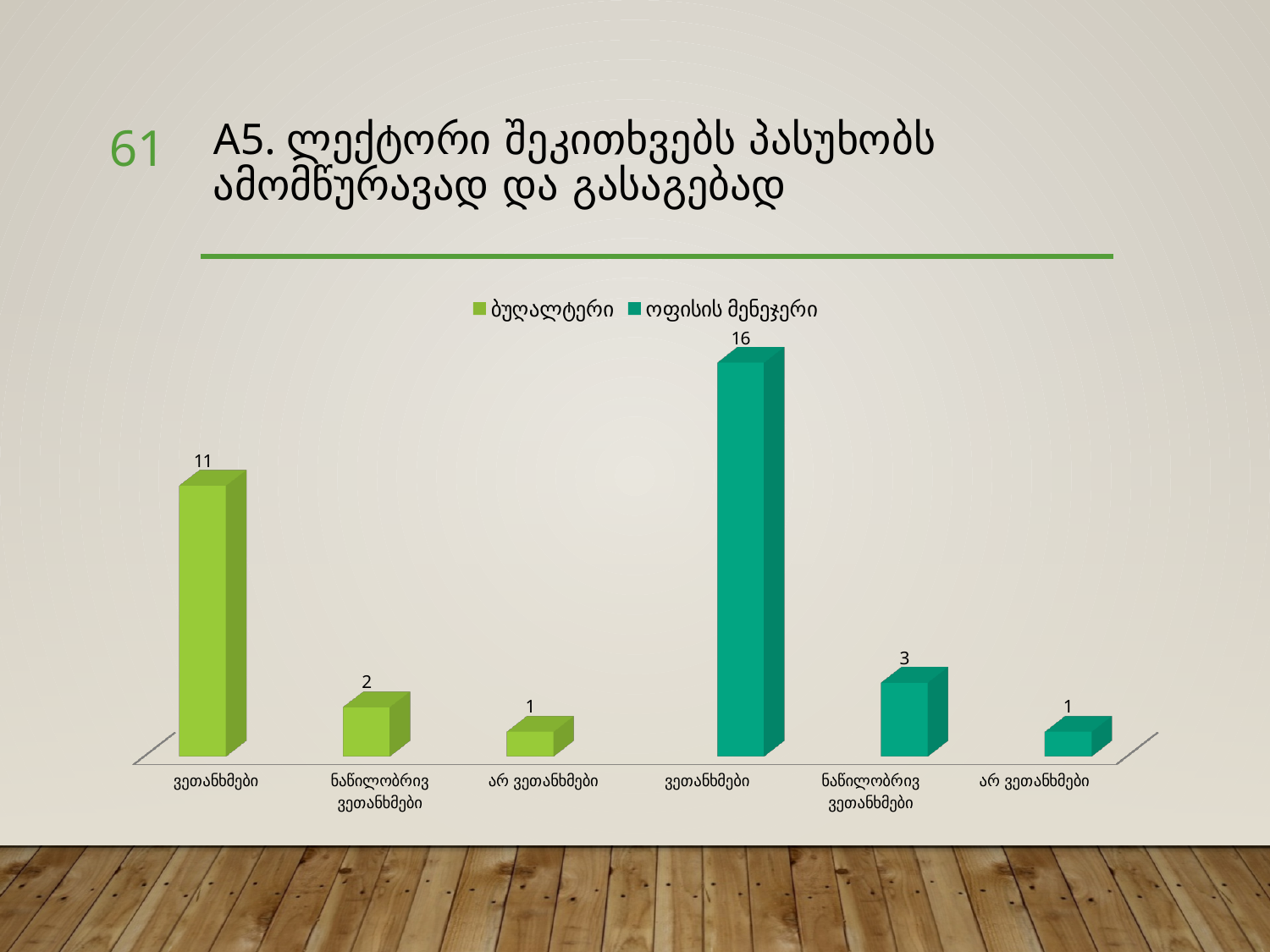
What kind of chart is shown on the slide? Bar chart What is the value for ვეთანხმები in the ბუღალტერი series? 11 Which category has the lowest value in the ოფისის მენეჯერი series? არ ვეთანხმები Which bar has the highest value on the chart? ვეთანხმები (ოფისის მენეჯერი) Which is larger: ნაწილობრივ ვეთანხმები for ბუღალტერი or for ოფისის მენეჯერი? ოფისის მენეჯერი What is the value for ვეთანხმები in the ოფისის მენეჯერი series? 16 What is the difference between the ვეთანხმები values for ოფისის მენეჯერი and ბუღალტერი? 5 How many series does the legend list? 2 How many bars are plotted on the chart? 6 What is the total of the three values in the ბუღალტერი series? 14 What is the value for არ ვეთანხმები in the ბუღალტერი series? 1 What is the value for ნაწილობრივ ვეთანხმები in the ოფისის მენეჯერი series? 3